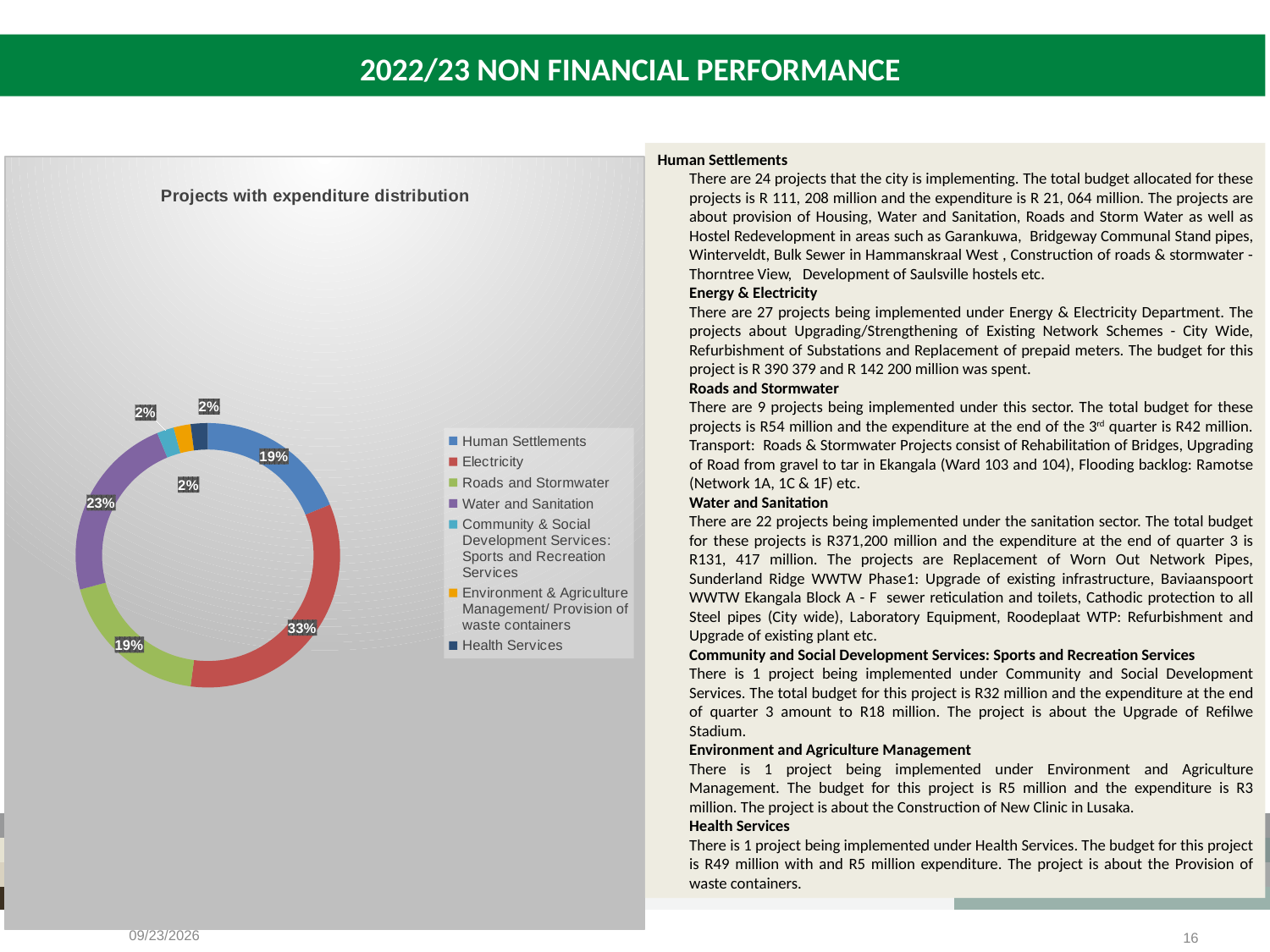
How many entries does the chart legend list? 7 What percentage of the expenditure distribution is for Electricity? 33% What percentage of the expenditure distribution is for Water and Sanitation? 23% What is the title of the chart? Projects with expenditure distribution What share of the doughnut does the Roads and Stormwater slice represent? 19% What percentage of the expenditure distribution is for Health Services? 2% What kind of chart is shown on the slide? Doughnut (pie) chart What is the difference between the Electricity share and the Water and Sanitation share? 10% What percentage of the expenditure distribution is for Human Settlements? 19% Which category has the largest share of the expenditure distribution? Electricity Which has a larger share: Water and Sanitation or Roads and Stormwater? Water and Sanitation How many categories are shown in the chart? 7